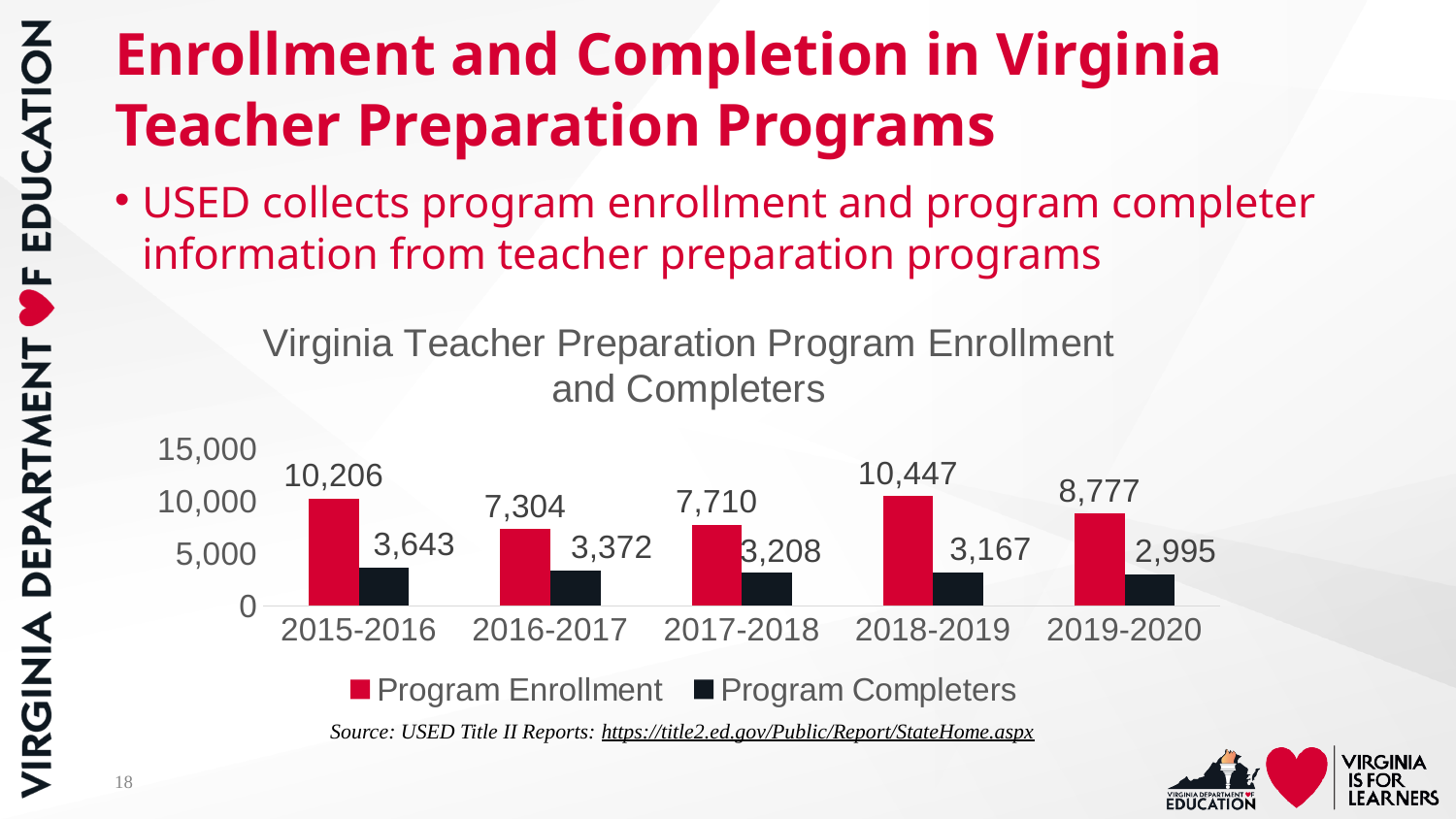
How many Program Completers were there in 2016-2017? 3,372 How many academic years are shown on the x axis? 5 What is the title of the chart? Virginia Teacher Preparation Program Enrollment and Completers Which year had the lowest number of Program Completers? 2019-2020 Is the Program Enrollment value for 2019-2020 greater or less than 10,000? less How many series does the legend list? 2 What was Program Enrollment in 2018-2019? 10,447 Do the Program Completers values rise or fall from 2015-2016 to 2019-2020? fall What kind of chart is shown on the slide? bar chart Which is larger: Program Enrollment in 2016-2017 or in 2017-2018? 2017-2018 What is the difference between Program Enrollment and Program Completers in 2015-2016? 6,563 Which year had the highest Program Enrollment? 2018-2019